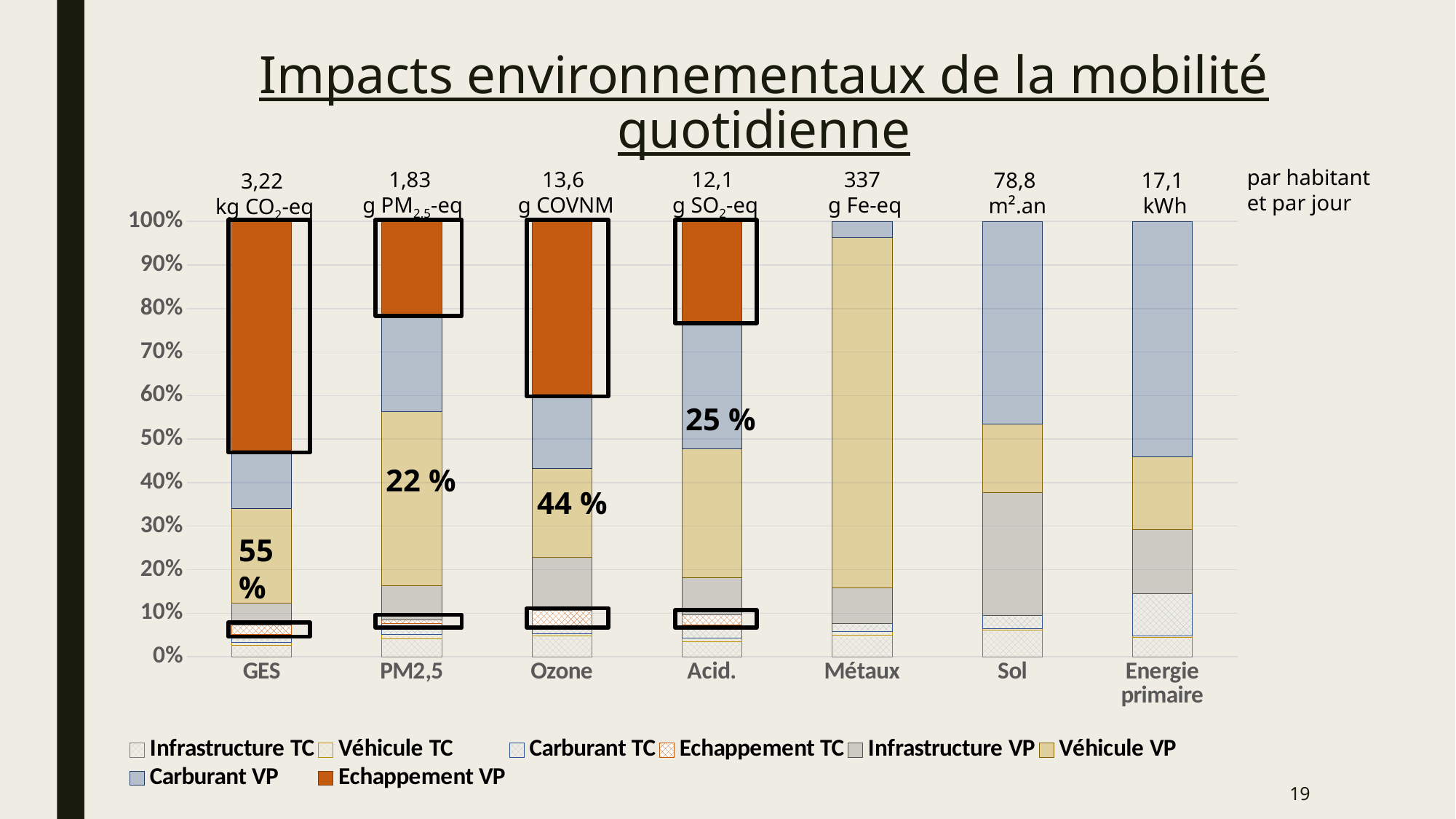
Is the Echappement VP share in the GES bar larger or smaller than in the Acid. bar? larger What percentage is annotated on the Ozone bar? 44 % What total value is printed above the Energie primaire bar? 17,1 kWh How many categories are shown along the x axis of the chart? 7 What total value is printed above the GES bar? 3,22 kg CO2-eq Which category has the largest Echappement VP share? GES How many series does the chart legend list? 8 What is the title of the chart slide? Impacts environnementaux de la mobilité quotidienne What total value is printed above the Métaux bar? 337 g Fe-eq Is the Véhicule VP share in the Métaux bar greater or less than 70%? greater What percentage is annotated on the PM2,5 bar? 22 % What kind of chart is shown on the slide? stacked bar chart